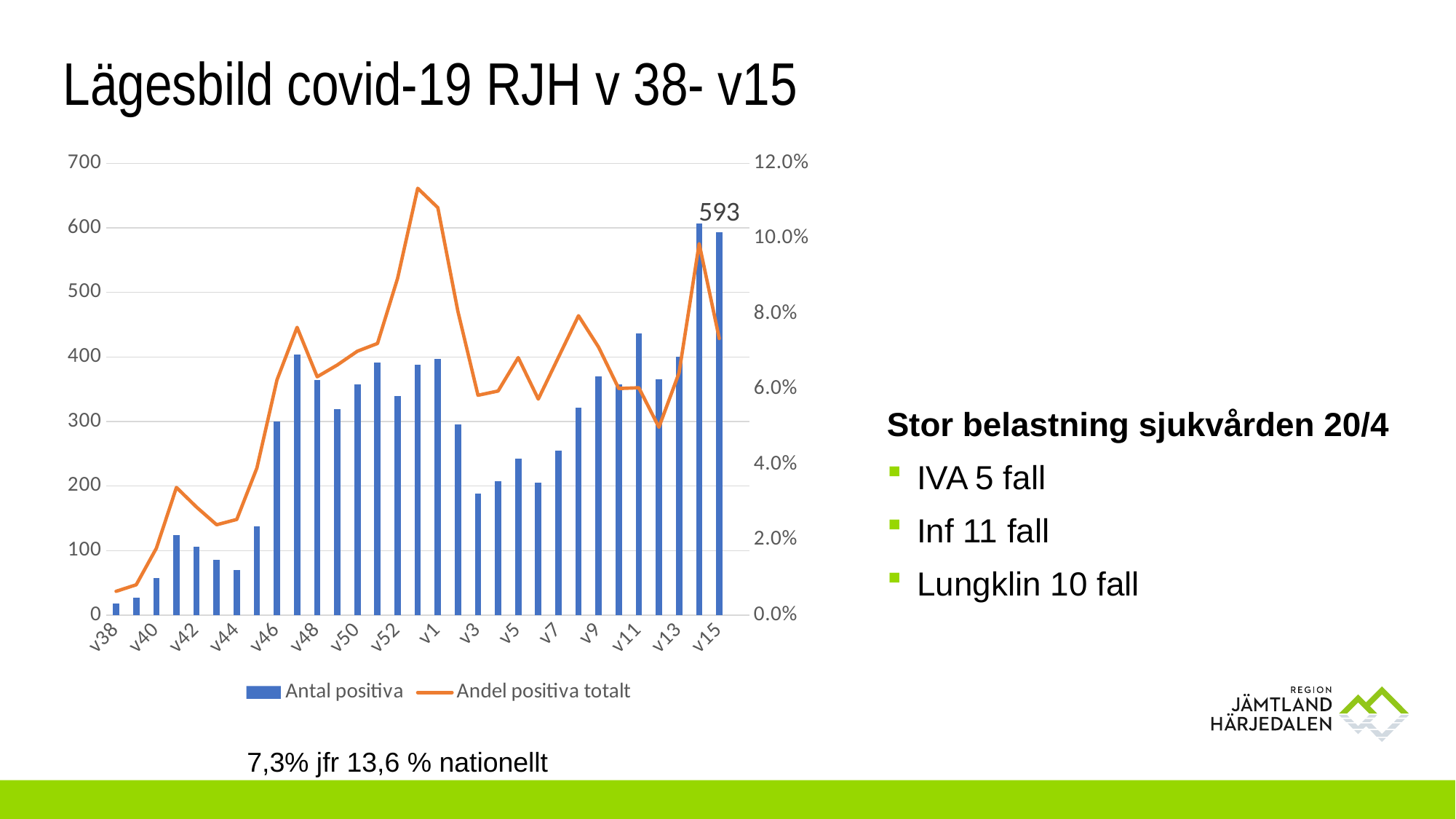
Is the Andel positiva totalt value for v38 greater or less than 2.0%? less Do the Antal positiva bars rise or fall from v38 to v47? rise Is the Antal positiva value for v48 greater or less than 400? less What is the value of Antal positiva for v15? 593 What are the two series named in the legend? Antal positiva and Andel positiva totalt Which is larger, the Antal positiva bar for v42 or for v44? v42 Is the Andel positiva totalt value at its peak around v52 greater or less than 10.0%? greater How many series does the legend list? 2 Which week has the lowest Antal positiva bar? v38 What kind of chart is shown on the slide? A bar chart combined with a line chart